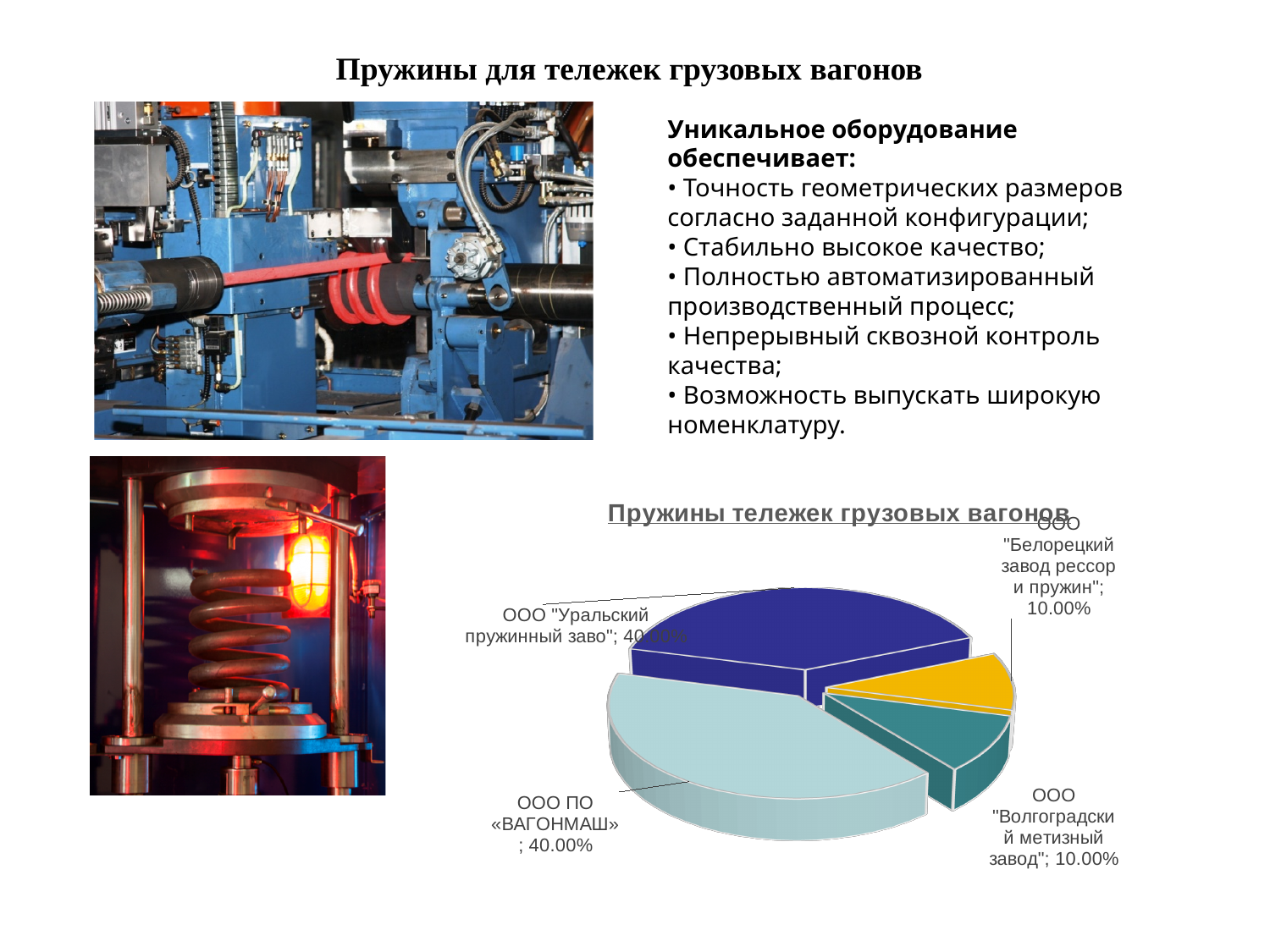
What kind of chart is shown on the slide? pie chart What is the title of the chart on the slide? Пружины тележек грузовых вагонов What share of the pie does ООО "Волгоградский метизный завод" hold? 10.00% What share of the pie does ООО "Белорецкий завод рессор и пружин" hold? 10.00% Which has the larger share: ООО ПО «ВАГОНМАШ» or ООО "Белорецкий завод рессор и пружин"? ООО ПО «ВАГОНМАШ» What is the difference between the shares of ООО ПО «ВАГОНМАШ» and ООО "Волгоградский метизный завод"? 30.00% What share of the pie does ООО ПО «ВАГОНМАШ» hold? 40.00% How many slices does the pie chart have? 4 What share of the pie does ООО "Уральский пружинный заво" hold? 40.00% Is the share for ООО "Волгоградский метизный завод" greater or less than 20%? less Which slice of the pie chart is coloured yellow? ООО "Белорецкий завод рессор и пружин" What is the combined share of ООО "Белорецкий завод рессор и пружин" and ООО "Волгоградский метизный завод"? 20.00%